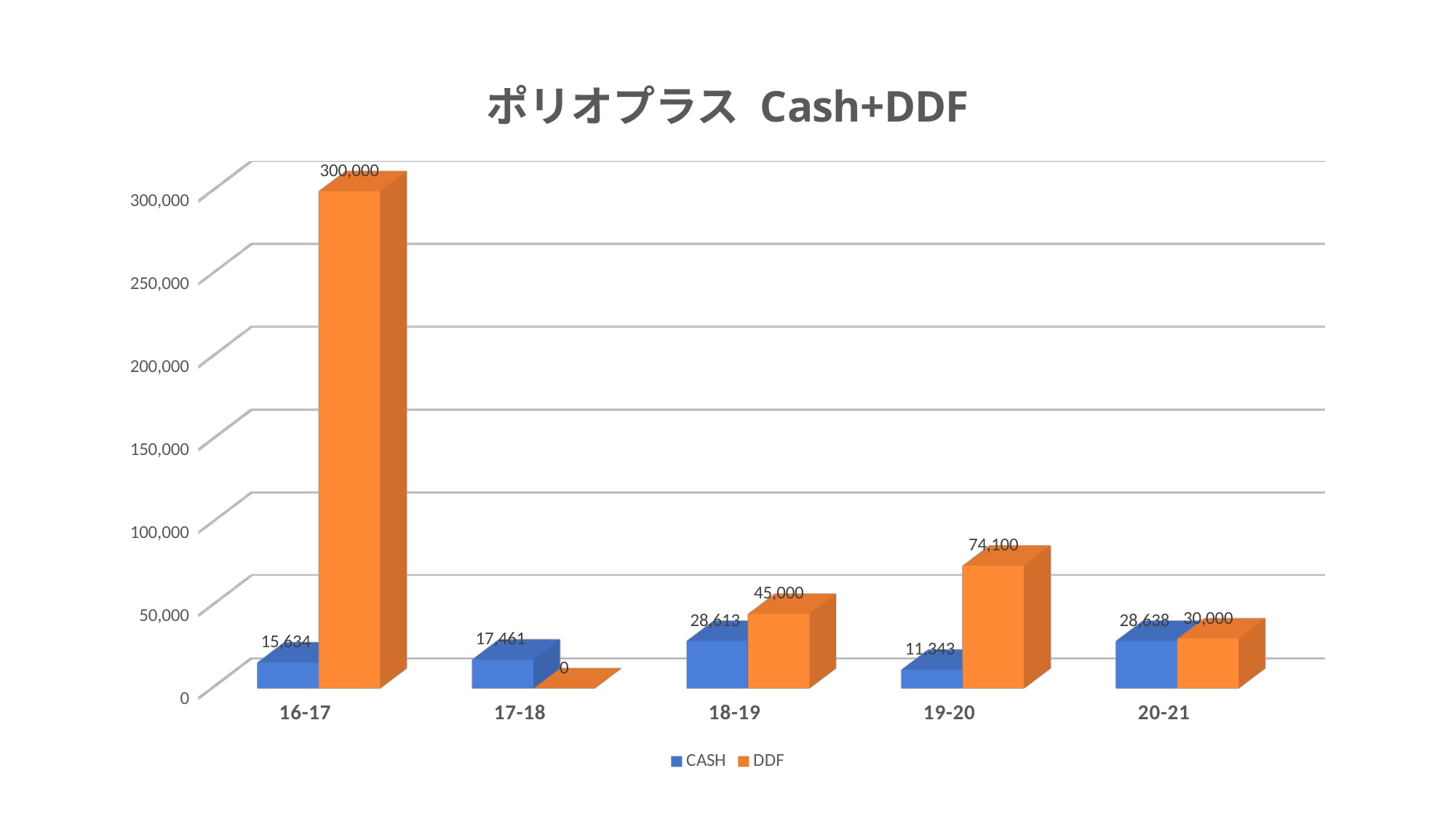
Which is larger for 20-21, CASH or DDF? DDF What is the DDF value for 19-20? 74,100 How many series does the legend list? 2 What kind of chart is shown? bar chart What is the CASH value for 16-17? 15,634 Which year has the highest DDF value? 16-17 What is the title of the chart? ポリオプラス Cash+DDF Which year has the lowest CASH value? 19-20 What is the DDF value for 17-18? 0 How many year categories are shown on the x axis? 5 What is the difference between the DDF and CASH values for 18-19? 16,387 Is the DDF value for 19-20 greater or less than 50,000? greater